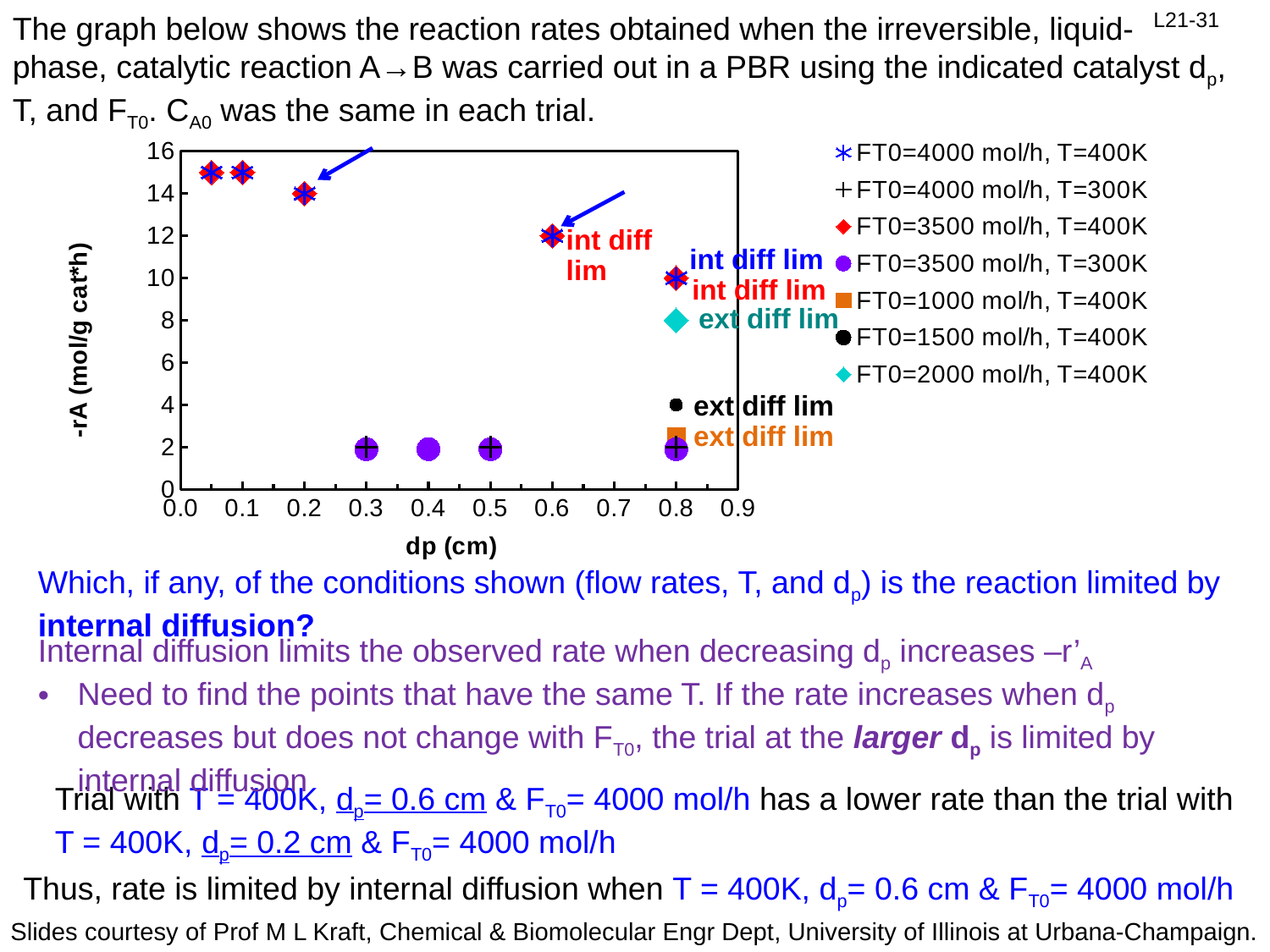
Is the reaction rate for the FT0=2000 mol/h, T=400K trial at dp=0.8 cm greater or less than 10? less Is the reaction rate for the T=300K trials at dp=0.4 cm greater or less than 4? less What is the label of the x axis of the chart? dp (cm) How many data points are plotted for the FT0=3500 mol/h, T=300K series? 4 Which temperature, 300K or 400K, gives the lowest reaction rates on the chart? 300K Which has the higher reaction rate at T=400K and FT0=4000 mol/h: dp=0.2 cm or dp=0.6 cm? dp=0.2 cm What is the label of the y axis of the chart? -rA (mol/g cat*h) For the T=400K trials, does the reaction rate -rA rise or fall as dp increases? fall What kind of chart is shown on the slide? scatter plot Is the reaction rate for the T=400K, FT0=4000 mol/h trial at dp=0.6 cm greater or less than 10? greater How many series does the chart legend list? 7